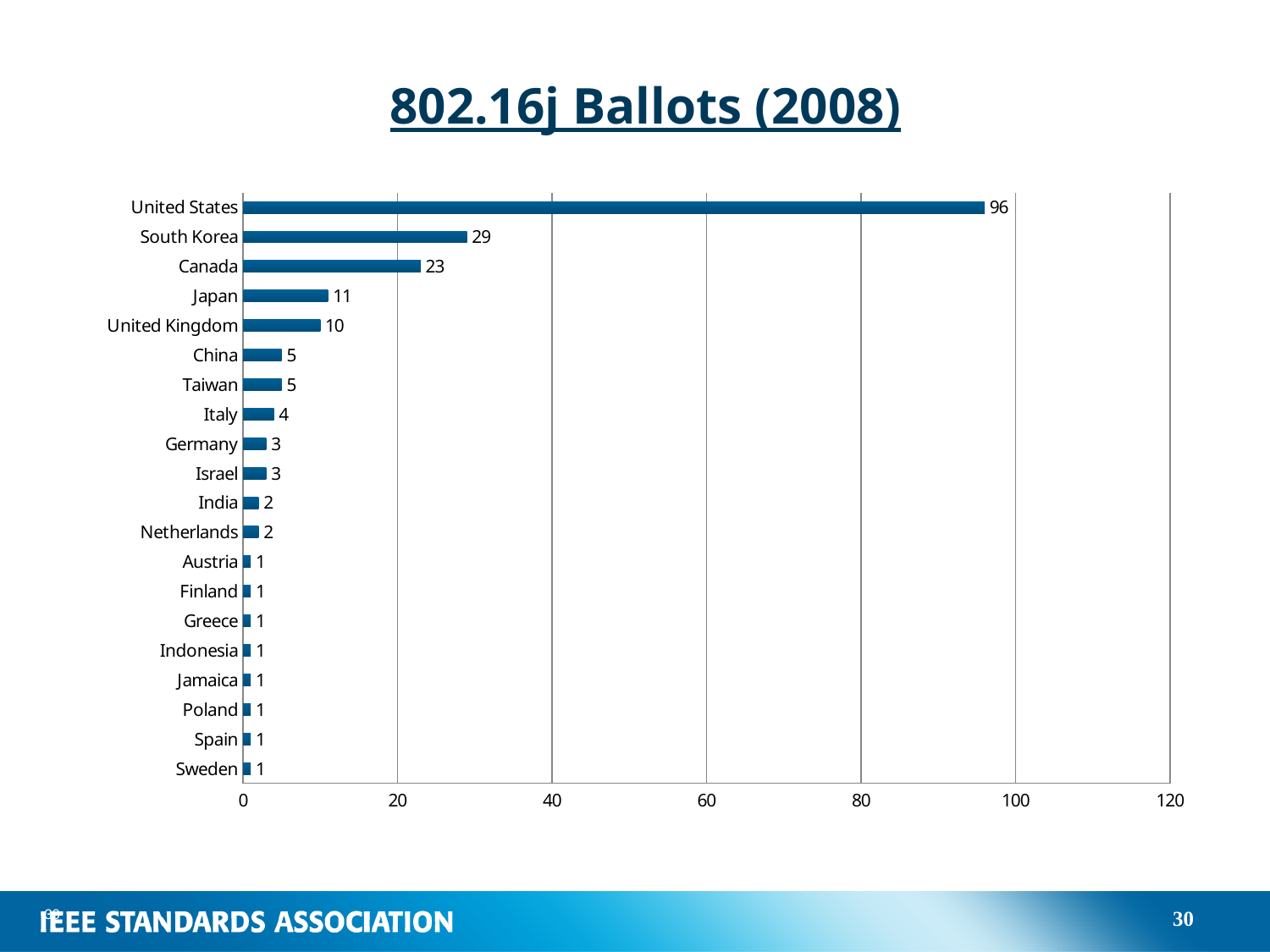
What is the difference between the values for United States and South Korea? 67 What is the difference between the values for Japan and United Kingdom? 1 What kind of chart is shown on the slide? bar chart How many countries are shown on the chart? 20 Is the value for United States greater or less than 80? greater Which is larger, the value for Canada or the value for Japan? Canada What is the value for South Korea? 29 What is the value for United States? 96 Which country has the highest value? United States What is the title of the chart? 802.16j Ballots (2008) What is the value for Canada? 23 What is the value for United Kingdom? 10